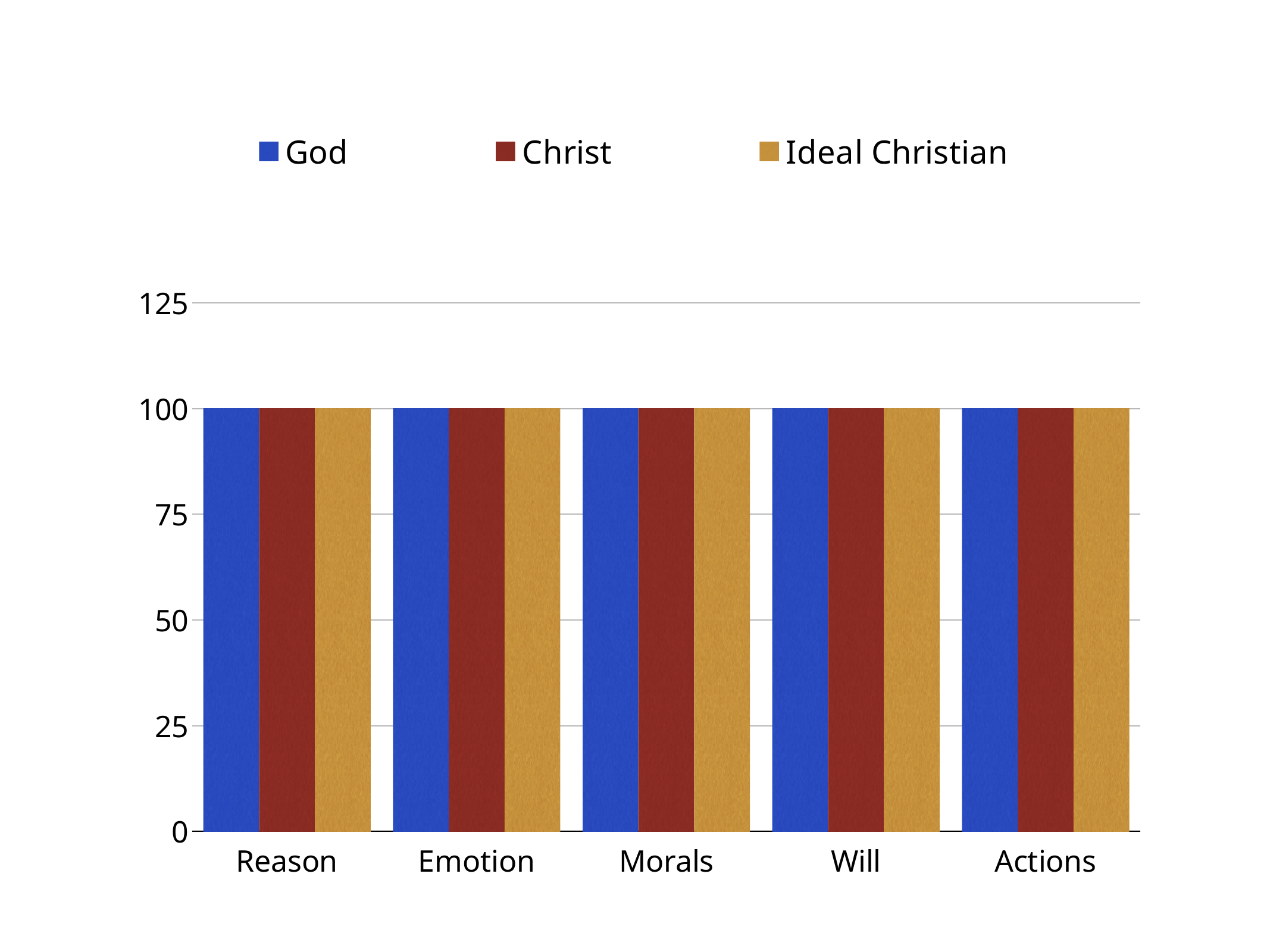
Is the value for Christ in the Emotion category greater or less than 75? greater What is the difference between the God value and the Christ value in the Reason category? 0 How many series does the legend list? 3 What kind of chart is shown on the slide? bar chart What is the value for God in the Reason category? 100 Is the value for Ideal Christian in the Will category greater or less than 125? less What is the value for God in the Will category? 100 What is the value for Christ in the Morals category? 100 Which series is shown in blue in the legend? God What is the value for Ideal Christian in the Actions category? 100 How many categories are shown on the x axis? 5 Which series is shown in gold in the legend? Ideal Christian